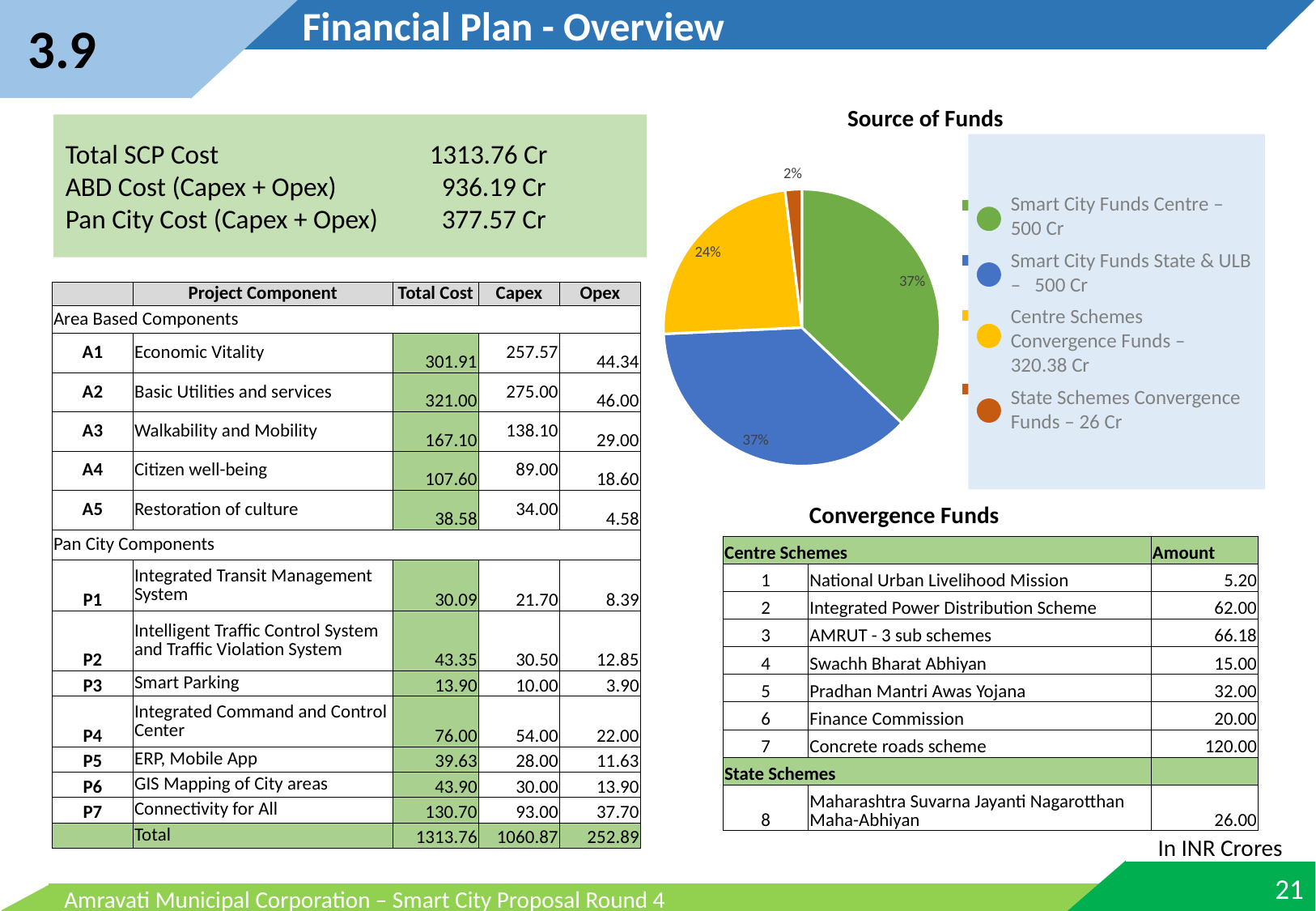
According to the legend of the "Source of Funds" pie chart, what amount is given for State Schemes Convergence Funds? 26 Cr In the "Source of Funds" pie chart, what share is labelled for Centre Schemes Convergence Funds? 24% In the "Source of Funds" pie chart, what share is labelled for State Schemes Convergence Funds? 2% What colour is the Smart City Funds State & ULB slice in the "Source of Funds" pie chart? blue In the "Source of Funds" pie chart, which is larger: Centre Schemes Convergence Funds or State Schemes Convergence Funds? Centre Schemes Convergence Funds According to the legend of the "Source of Funds" pie chart, what amount is given for Centre Schemes Convergence Funds? 320.38 Cr What kind of chart is the "Source of Funds" chart? pie chart In the "Source of Funds" pie chart, what share is labelled for Smart City Funds Centre? 37% How many slices does the "Source of Funds" pie chart have? 4 In the "Source of Funds" pie chart, what is the difference in percentage points between the Centre Schemes Convergence Funds slice and the State Schemes Convergence Funds slice? 22 percentage points How many entries does the legend of the "Source of Funds" pie chart list? 4 Which slice of the "Source of Funds" pie chart is the smallest? State Schemes Convergence Funds